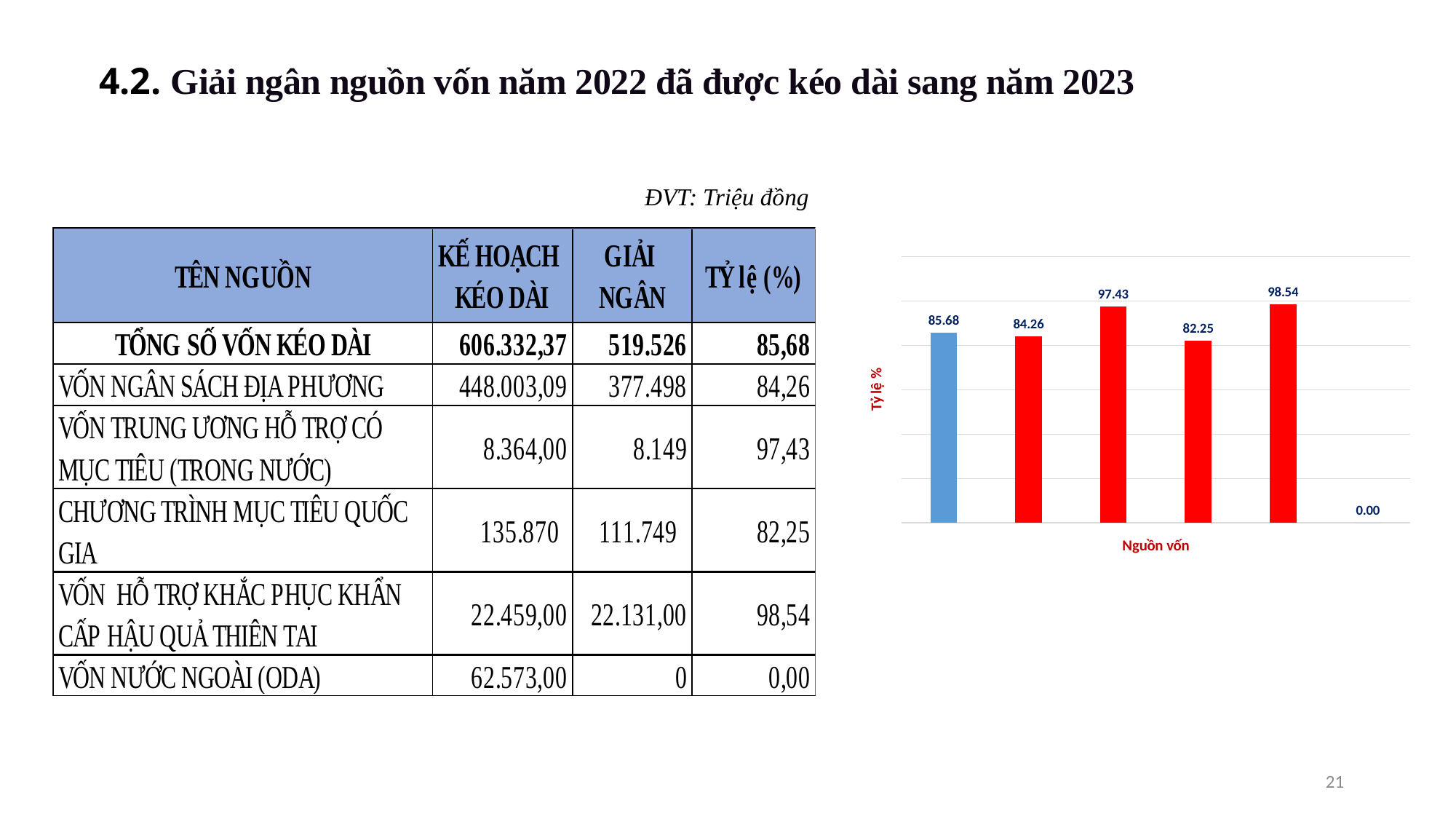
What kind of chart is shown on the right of the slide? bar chart Which bar has the highest value in the chart? the fifth bar (98.54) Which bar has the lowest value in the chart? the sixth bar (0.00) What is the data label on the last bar in the chart? 0.00 What is the data label on the third bar in the chart? 97.43 What is the data label on the first (blue) bar in the chart? 85.68 What is the label of the horizontal axis in the chart? Nguồn vốn What is the difference between the fifth bar (98.54) and the fourth bar (82.25) in the chart? 16.29 What is the data label on the fifth bar in the chart? 98.54 Which is larger in the chart, the second bar or the third bar? the third bar (97.43) How many bars are plotted in the chart? 6 What is the label of the vertical axis in the chart? Tỷ lệ %